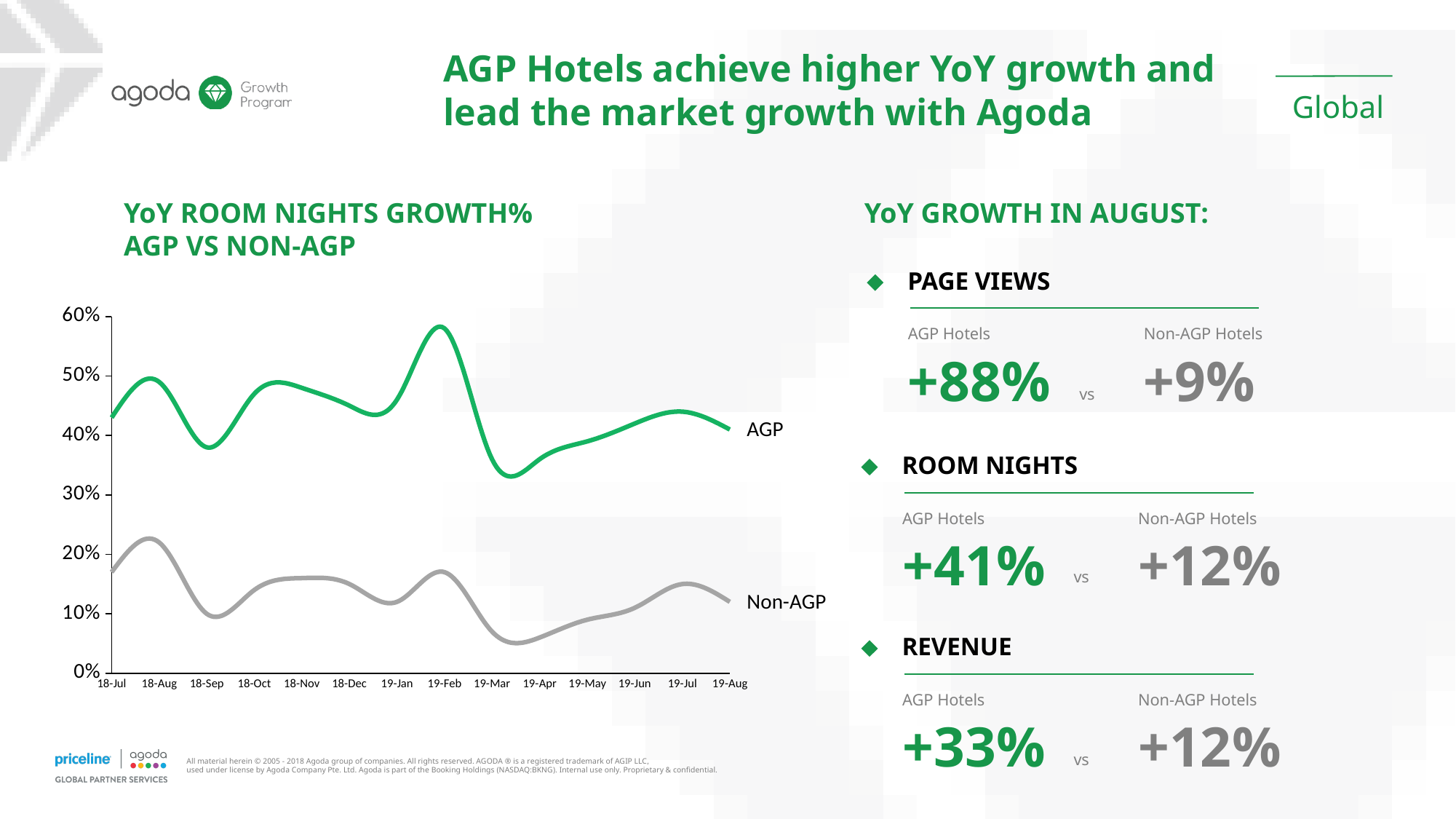
Does the Non-AGP line rise or fall between 19-Mar and 19-Jul? rise How many series does the YoY Room Nights Growth% chart plot? 2 In which month does the AGP line reach its highest value? 19-Feb Is the AGP value at 19-Feb greater or less than 50%? greater In which month does the Non-AGP line reach its lowest value? 19-Apr What type of chart is shown on the slide? Line chart Is the Non-AGP value at 19-Mar greater or less than 10%? less How many months are shown on the x axis of the YoY Room Nights Growth% chart? 14 In which month does the Non-AGP line reach its highest value? 18-Aug Is the AGP value at 19-Mar greater or less than 40%? less At 19-Feb, which series has the higher YoY room nights growth, AGP or Non-AGP? AGP